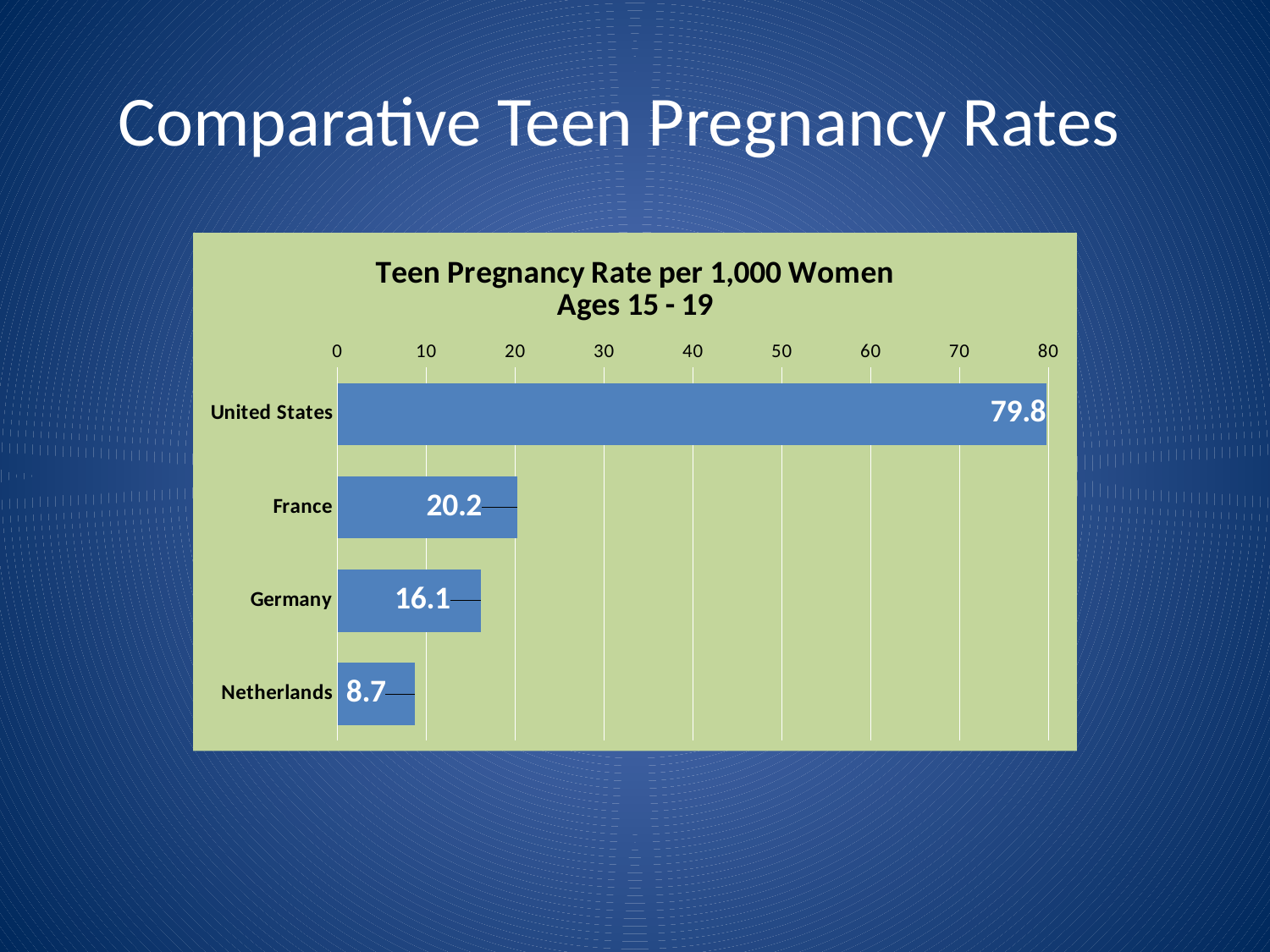
What is the teen pregnancy rate for the United States? 79.8 Which has a higher teen pregnancy rate, France or Germany? France What is the difference between the teen pregnancy rates of the United States and France? 59.6 Which country has the lowest teen pregnancy rate? Netherlands What kind of chart is shown on the slide? Bar chart What is the teen pregnancy rate for Germany? 16.1 What is the title of the chart? Teen Pregnancy Rate per 1,000 Women Ages 15 - 19 How many countries are shown in the chart? 4 What is the teen pregnancy rate for the Netherlands? 8.7 Which country has the highest teen pregnancy rate? United States What is the teen pregnancy rate for France? 20.2 What is the difference between the teen pregnancy rates of Germany and the Netherlands? 7.4